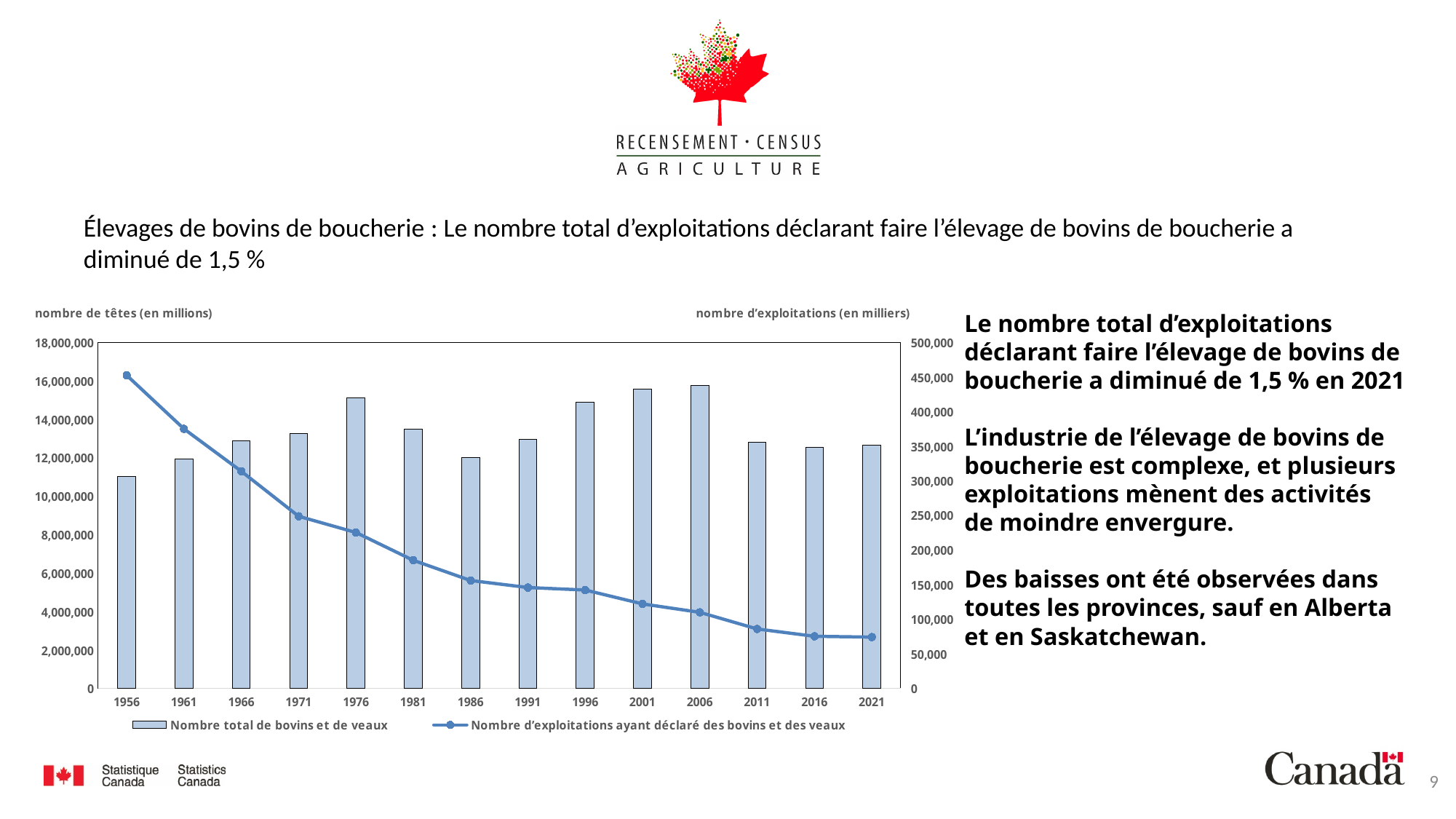
Is the value of the line for 1956 ('Nombre d'exploitations ayant déclaré des bovins et des veaux') greater or less than 400,000? greater Which year has the larger bar for 'Nombre total de bovins et de veaux', 1976 or 1986? 1976 Is the bar value for 1956 ('Nombre total de bovins et de veaux') greater or less than 12,000,000? less What kind of chart is shown on the slide? A combined bar and line chart What is the label of the left vertical axis of the chart? nombre de têtes (en millions) Is the value of the line for 2021 ('Nombre d'exploitations ayant déclaré des bovins et des veaux') greater or less than 100,000? less How many years are shown on the x axis of the chart? 14 In which year is the line 'Nombre d'exploitations ayant déclaré des bovins et des veaux' at its highest? 1956 How many series does the chart legend list? 2 Which year has the lowest bar for 'Nombre total de bovins et de veaux'? 1956 Does the line for 'Nombre d'exploitations ayant déclaré des bovins et des veaux' rise or fall from 1956 to 2021? It falls